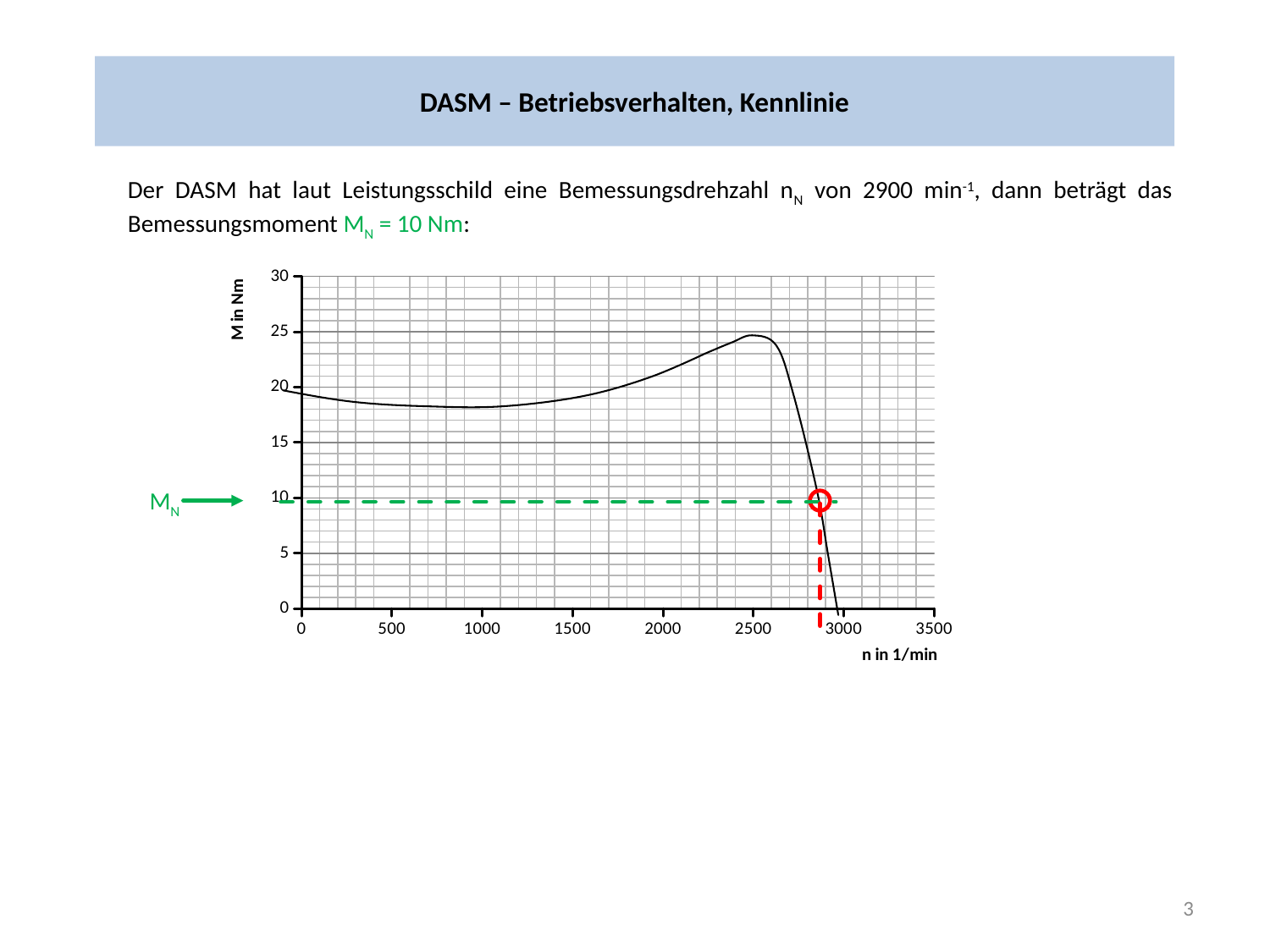
What is the label of the horizontal axis of the chart? n in 1/min What kind of chart is shown on the slide? line chart Does the torque curve rise or fall between n = 2500 1/min and n = 3000 1/min? fall Is the torque value at n = 2500 1/min greater or less than 20 Nm? greater What value of the rated torque M_N is marked by the green dashed line on the chart? 10 Nm Which is larger, the torque at n = 2500 1/min or the torque at n = 2900 1/min? the torque at n = 2500 1/min At which speed n_N is the rated operating point marked with the red circle on the chart? 2900 min^-1 What is the label of the vertical axis of the chart? M in Nm Is the torque value at n = 1000 1/min greater or less than 20 Nm? less Is the torque value at n = 500 1/min greater or less than 15 Nm? greater Does the torque curve rise or fall between n = 1000 1/min and n = 2500 1/min? rise